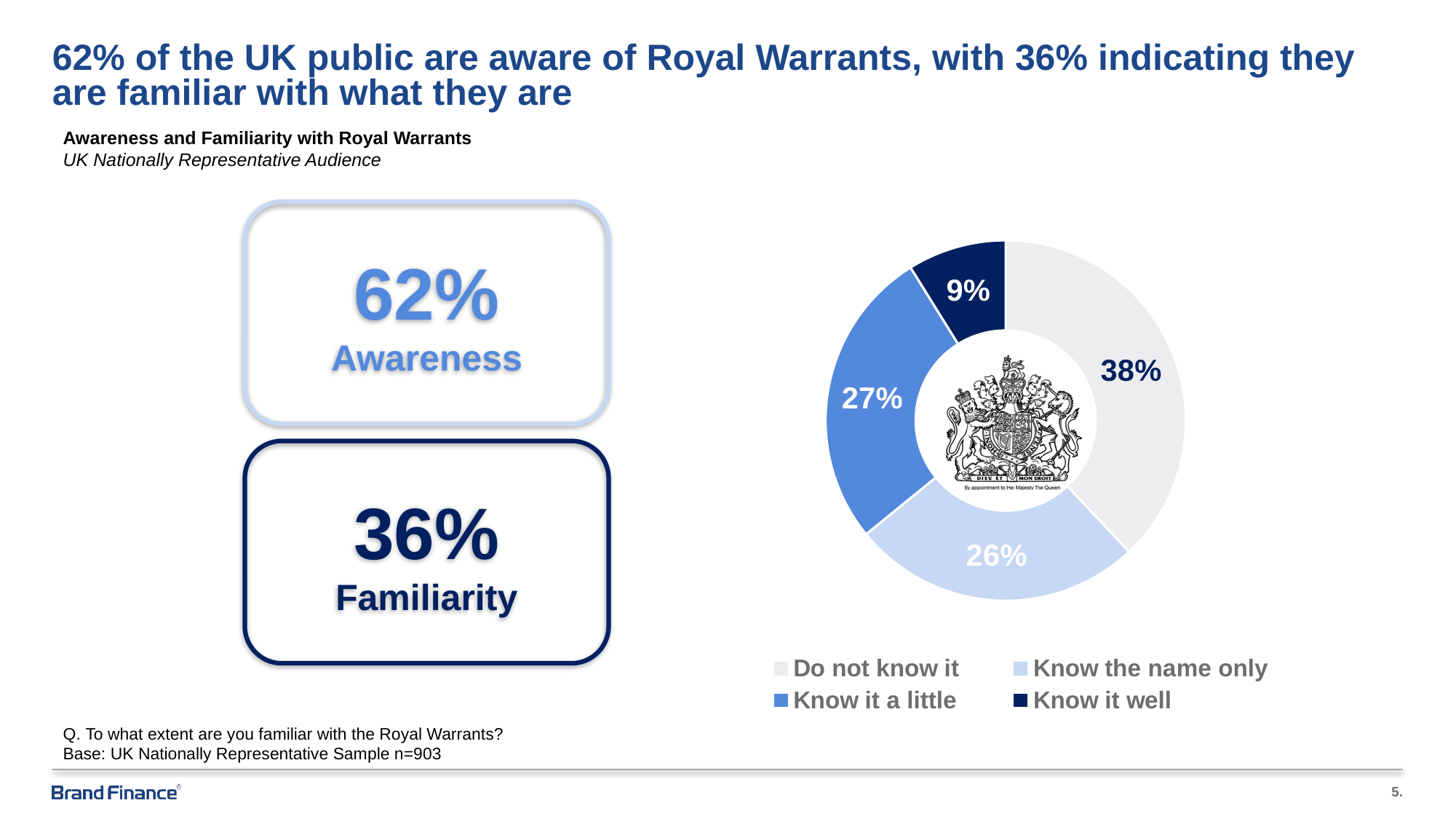
What is the difference in percentage points between 'Do not know it' and 'Know it well'? 29 Which response category has the smallest share of the pie? Know it well What percentage of respondents know Royal Warrants a little? 27% What share of respondents said they do not know Royal Warrants? 38% How many categories does the pie chart show? 4 Which response category has the largest share of the pie? Do not know it What percentage of respondents know Royal Warrants well? 9% What percentage of respondents know the name only? 26% What kind of chart is shown on the slide? Doughnut chart Which is larger, the share for 'Know it a little' or 'Know the name only'? Know it a little How many entries does the legend list? 4 What is the title of the chart? Awareness and Familiarity with Royal Warrants